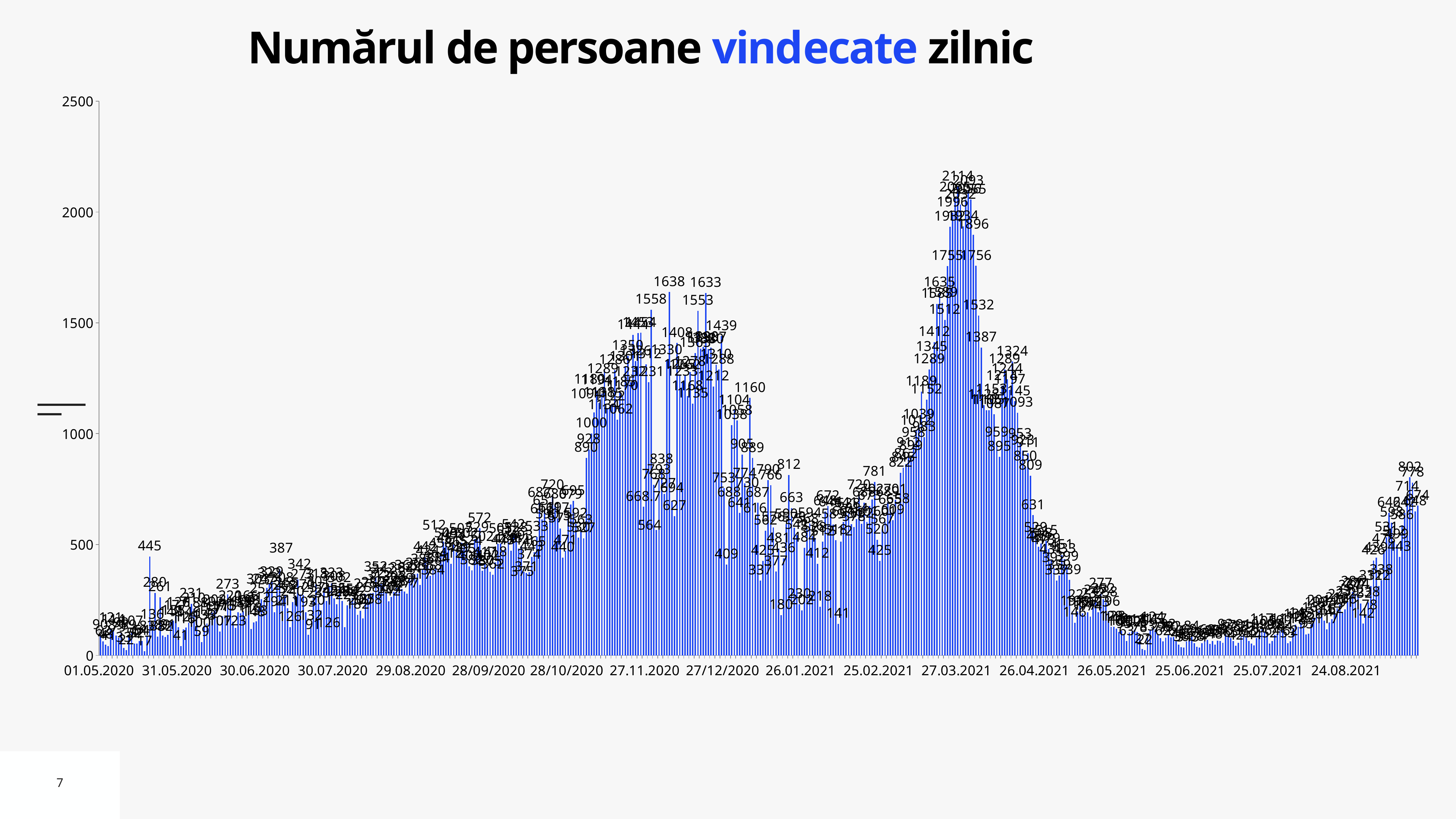
What is the title of the chart? Numărul de persoane vindecate zilnic What colour are the bars in the chart? blue What is the difference between the overall peak value (2114) and the November 2020 peak value (1638)? 476 Do the values rise or fall between 26.04.2021 and 26.05.2021? fall Are the values around 25.06.2021 greater or less than 500? less Is the value of the tallest bar greater or less than 2000? greater What is the value of the tallest bar in the peak around 27.11.2020? 1638 What is the highest value labelled on the chart? 2114 What kind of chart is shown on the slide? bar chart Do the values rise or fall from 24.08.2021 to the end of the chart? rise Which peak is higher: the one around 27.03.2021 or the one around 27.11.2020? the one around 27.03.2021 What is the difference between the bars labelled 802 and 714 near the right end of the chart? 88